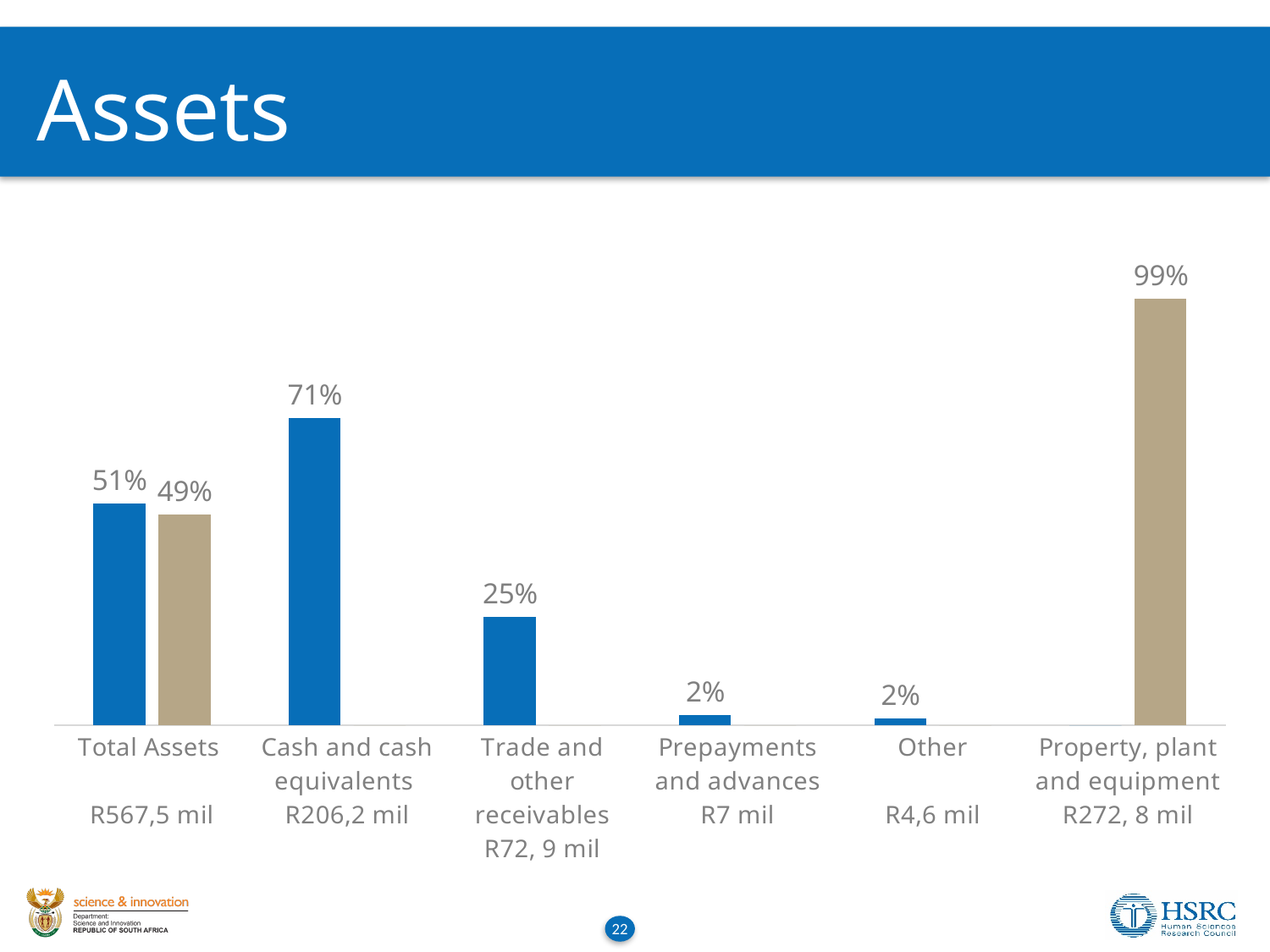
What kind of chart is shown on the slide? bar chart What is the percentage shown for Cash and cash equivalents? 71% What is the percentage shown for Property, plant and equipment? 99% How many categories are shown along the x axis? 6 What is the title of the slide containing the chart? Assets What is the difference between the percentages for Cash and cash equivalents and Trade and other receivables? 46% What is the percentage shown for Prepayments and advances? 2% Which is larger, the percentage for Cash and cash equivalents or for Trade and other receivables? Cash and cash equivalents Which category has the highest percentage bar? Property, plant and equipment What is the percentage shown for Trade and other receivables? 25% What are the two percentages shown for Total Assets? 51% and 49% What rand amount is shown under the Total Assets category label? R567,5 mil